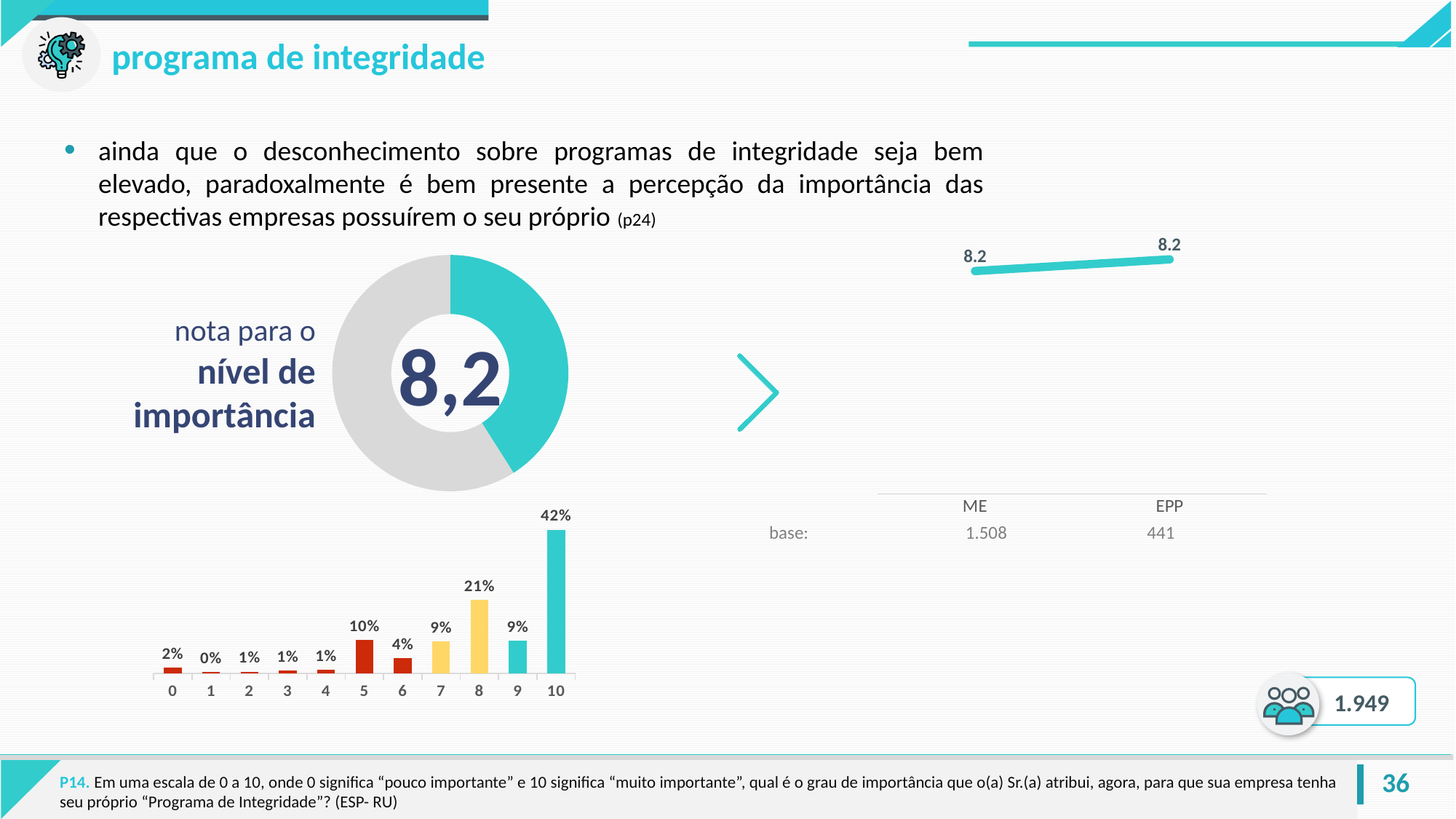
In the bar chart at the bottom left, what percentage is shown for score 5? 10% In the bar chart at the bottom left, which score has the lowest percentage? 1 In the line chart on the right, what value is shown for ME? 8.2 In the bar chart at the bottom left, what percentage is shown for score 8? 21% In the bar chart at the bottom left, which is larger: the percentage for score 6 or for score 7? 7 In the bar chart at the bottom left, what is the difference between the percentages for score 10 and score 8? 21% In the bar chart at the bottom left, what percentage is shown for score 10? 42% In the bar chart at the bottom left, which score has the highest percentage? 10 How many score categories are shown on the x axis of the bar chart at the bottom left? 11 What value is displayed in the centre of the donut chart labelled 'nota para o nível de importância'? 8,2 What kind of chart is the one at the bottom left showing percentages for scores 0 to 10? bar chart In the line chart on the right, what value is shown for EPP? 8.2